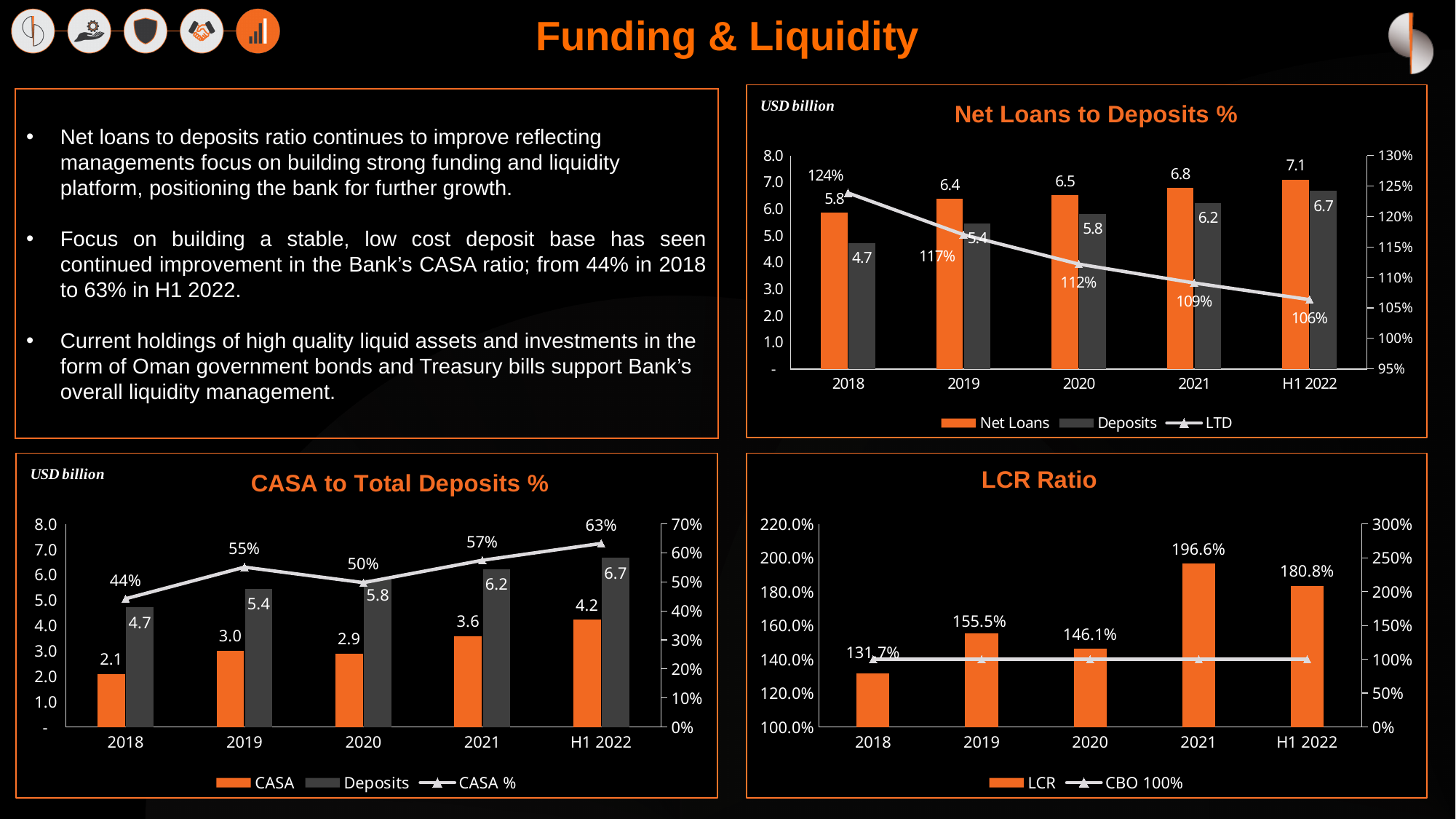
In the 'Net Loans to Deposits %' chart, how many series does the legend list? 3 In the 'LCR Ratio' chart, which year has the lowest LCR? 2018 In the 'LCR Ratio' chart, what is the LCR value for 2021? 196.6% In the 'LCR Ratio' chart, is the LCR for 2019 larger or smaller than the LCR for 2020? larger How many charts are on the slide? 3 In the 'CASA to Total Deposits %' chart, what is the difference between Deposits and CASA in 2021? 2.6 In the 'Net Loans to Deposits %' chart, what is the LTD value for 2018? 124% In the 'CASA to Total Deposits %' chart, what is the CASA value for 2020? 2.9 In the 'CASA to Total Deposits %' chart, which year has the lowest CASA %? 2018 In the 'Net Loans to Deposits %' chart, does the LTD line rise or fall from 2018 to H1 2022? fall In the 'Net Loans to Deposits %' chart, what is the Net Loans value for 2021? 6.8 In the 'Net Loans to Deposits %' chart, what is the difference between Net Loans and Deposits in H1 2022? 0.4